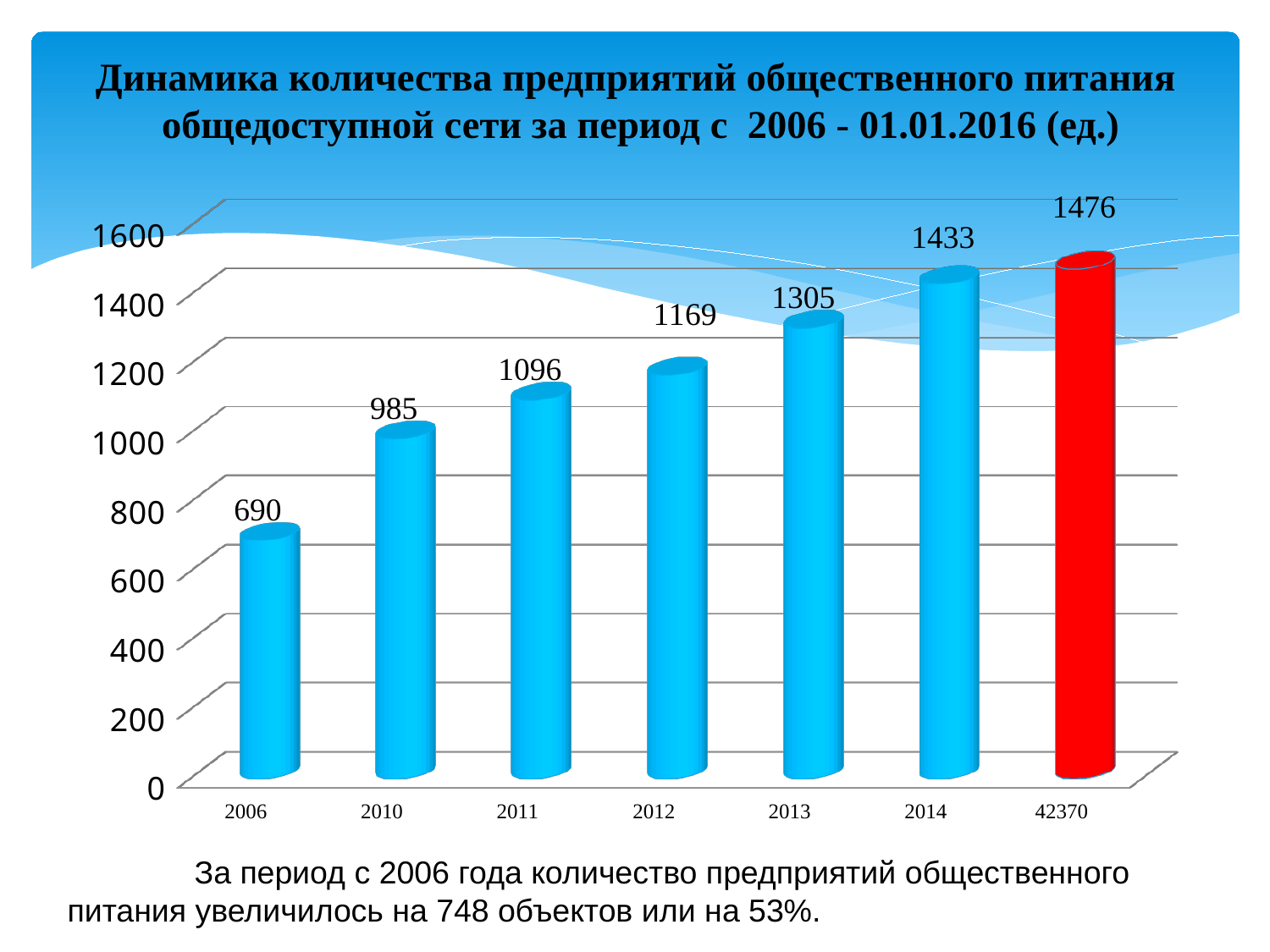
Is the value for 2010 greater or less than 1000? less Which category has the lowest value? 2006 What kind of chart is shown on the slide? bar chart Which is larger, the value for 2011 or the value for 2012? 2012 What is the value for 2013? 1305 What is the difference between the values for 2014 and 2013? 128 What is the difference between the values for 2012 and 2006? 479 Do the values rise or fall from left to right along the x axis? rise What is the value for the category labelled 42370? 1476 How many categories are shown on the x axis? 7 Which category has the highest value? 42370 What is the value for 2010? 985